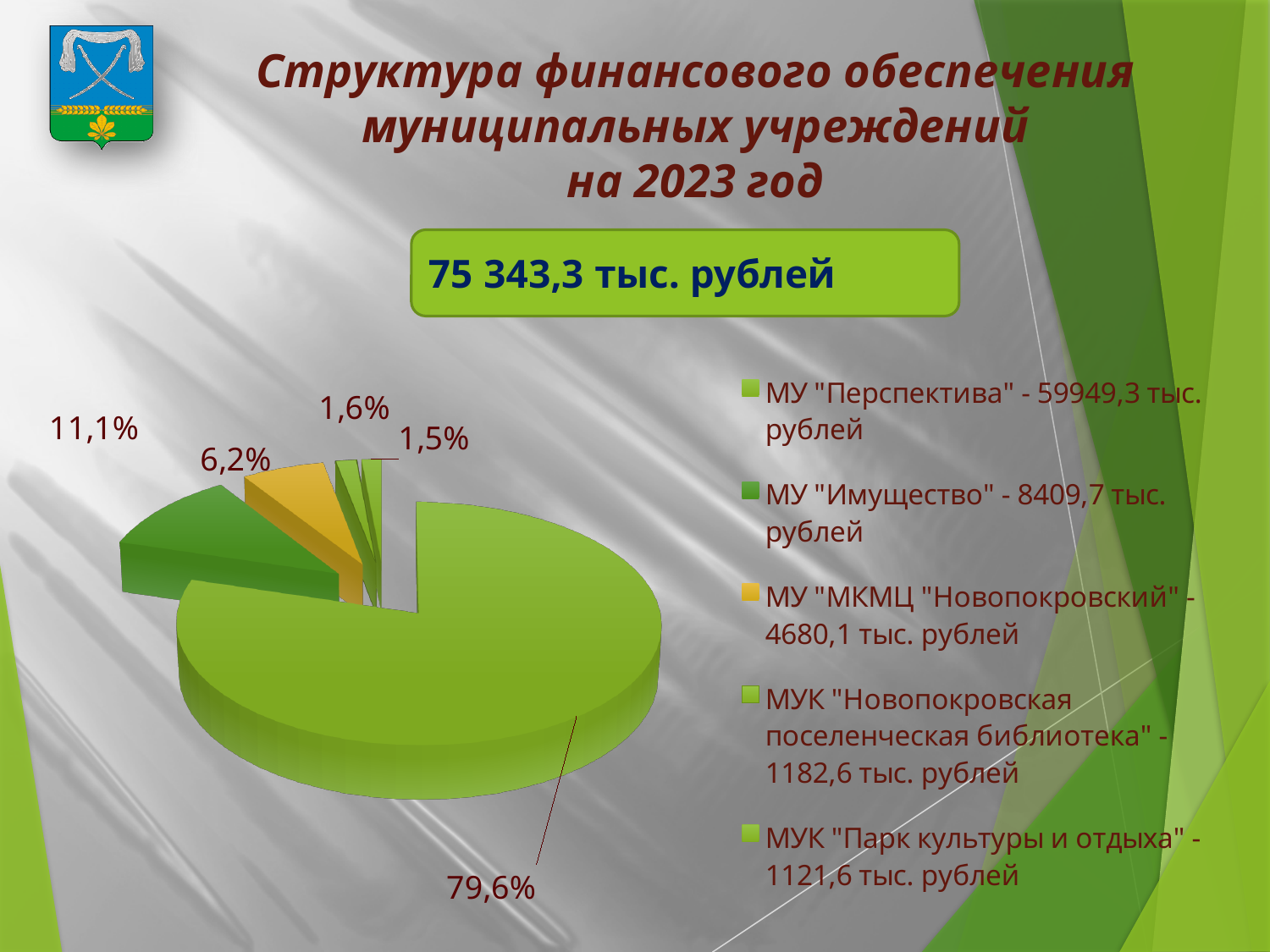
What kind of chart is shown on the slide? pie chart What share of the pie does МУ "Имущество" account for? 11,1% Which institution has the smallest slice of the pie? МУК "Парк культуры и отдыха" How many slices does the pie chart have? 5 How many entries does the legend list? 5 What share of the pie does МУ "Перспектива" account for? 79,6% What amount is listed in the legend for МУ "Имущество"? 8409,7 тыс. рублей What share of the pie does МУ "МКМЦ "Новопокровский" account for? 6,2% What total amount is shown above the chart? 75 343,3 тыс. рублей Which has a larger share of the pie, МУ "Имущество" or МУ "МКМЦ "Новопокровский"? МУ "Имущество" Which institution has the largest slice of the pie? МУ "Перспектива" What amount is listed in the legend for МУК "Новопокровская поселенческая библиотека"? 1182,6 тыс. рублей